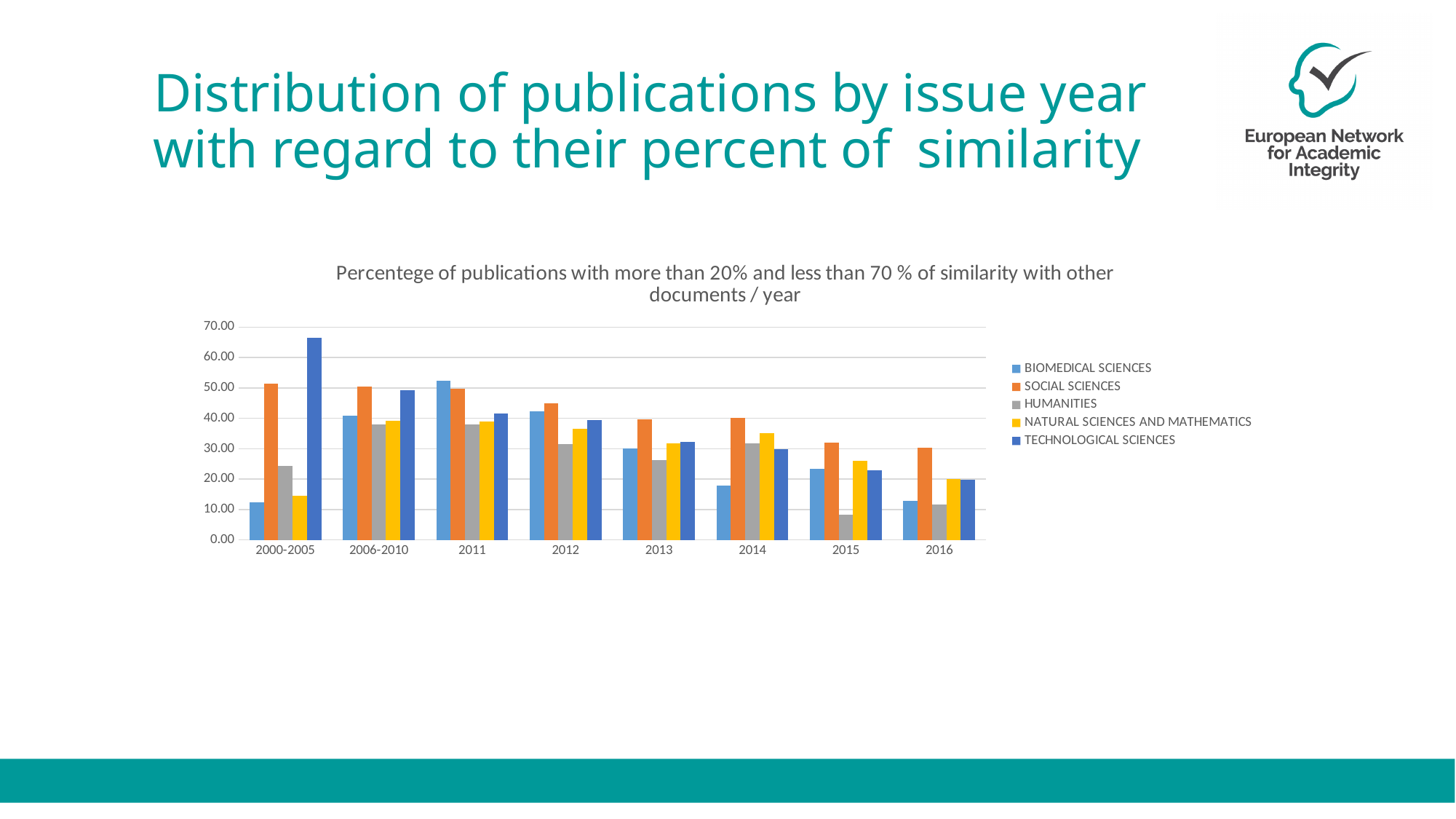
How many series does the legend list? 5 Do the Social Sciences values rise or fall from 2012 to 2016? fall What kind of chart is shown on the slide? Bar chart Which series has the highest bar in the 2014 category? Social Sciences How many year categories are shown on the x axis? 8 Is the value for Technological Sciences in 2000-2005 greater or less than 60? greater Which series has the tallest bar in the 2000-2005 category? Technological Sciences Is the value for Humanities in 2015 greater or less than 10? less In 2014, which is larger: Social Sciences or Biomedical Sciences? Social Sciences Is the value for Biomedical Sciences in 2000-2005 greater or less than 20? less What colour represents Social Sciences in the chart? Orange Which series has the lowest bar in the 2015 category? Humanities